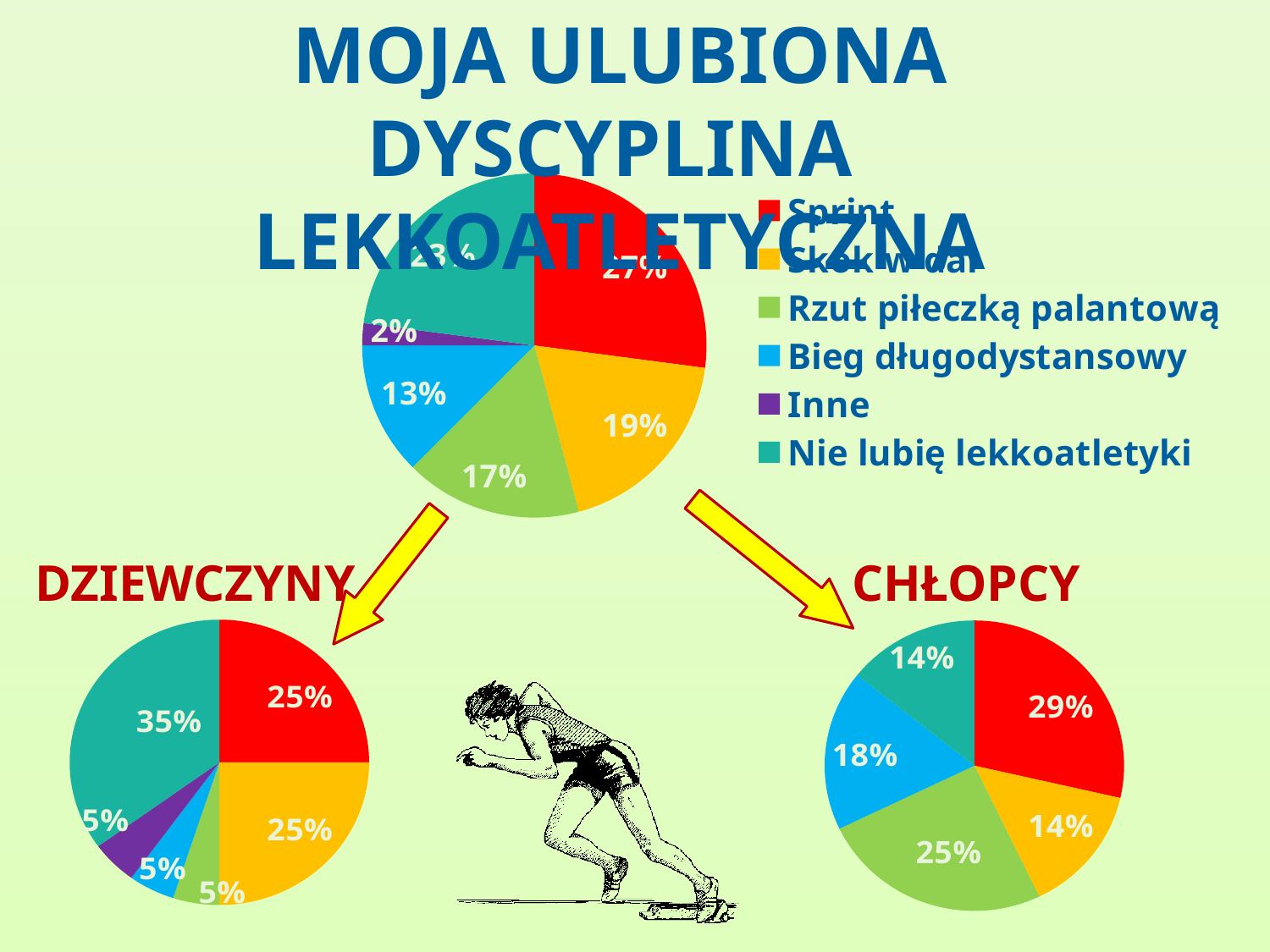
In the top pie chart, what share is shown for Skok w dal? 19% How many categories does the legend list? 6 In the DZIEWCZYNY pie chart, which category has the largest slice? Nie lubię lekkoatletyki In the top pie chart, what share is shown for Sprint? 27% In the CHŁOPCY pie chart, what share is shown for Rzut piłeczką palantową? 25% In the top pie chart, what share is shown for Bieg długodystansowy? 13% In the CHŁOPCY pie chart, how many slices are there? 5 What kind of chart is the DZIEWCZYNY chart? Pie chart In the CHŁOPCY pie chart, what share is shown for Sprint? 29% In the CHŁOPCY pie chart, what is the difference between the Sprint share and the Bieg długodystansowy share? 11 percentage points In the DZIEWCZYNY pie chart, what share is shown for Nie lubię lekkoatletyki? 35% In the top pie chart, which category has the smallest slice? Inne